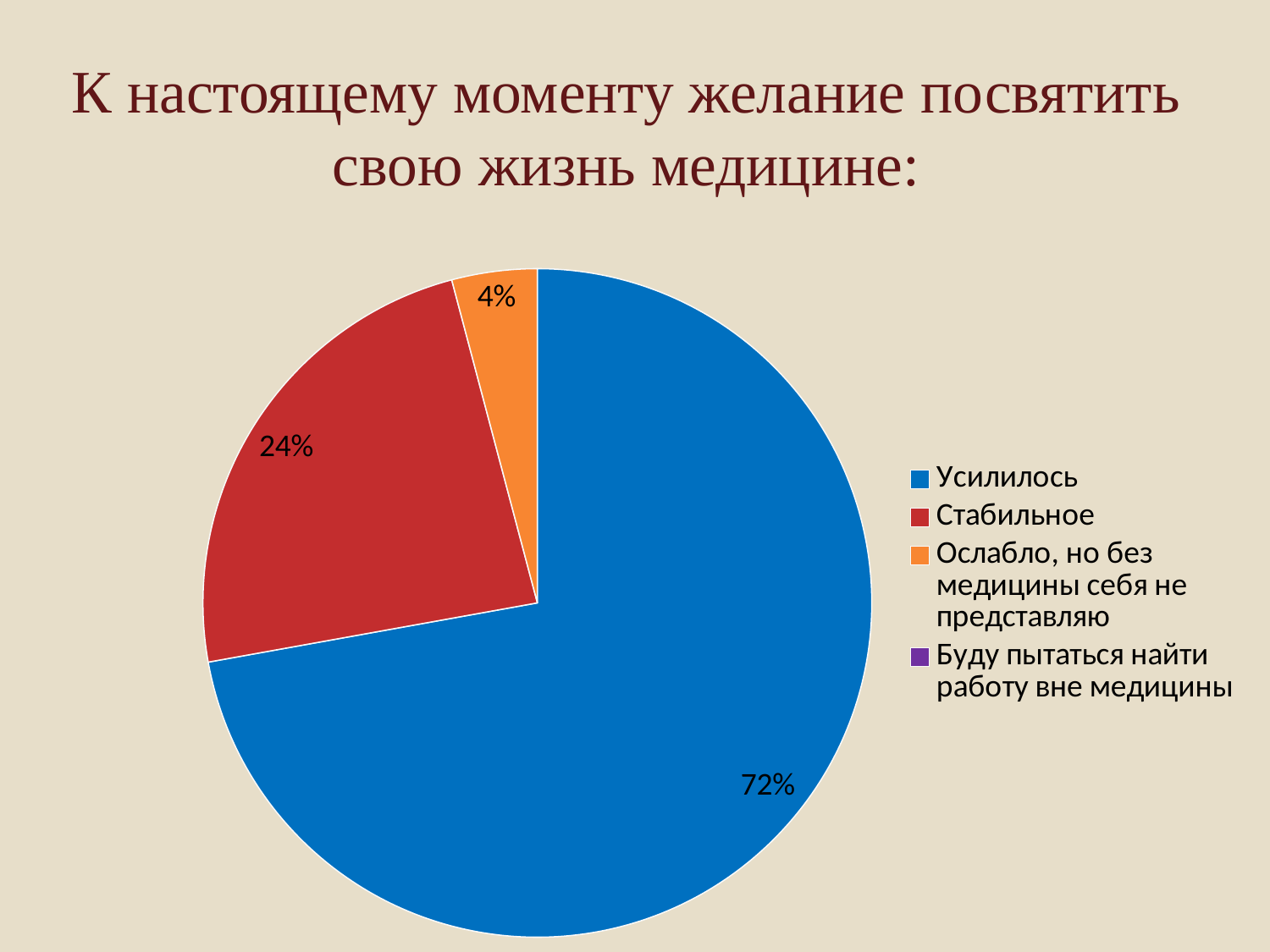
Which category has the largest slice of the pie? Усилилось What share of the pie is labelled for "Ослабло, но без медицины себя не представляю"? 4% How many slices of the pie have a percentage label? 3 Which slice is larger: "Стабильное" or "Ослабло, но без медицины себя не представляю"? Стабильное What kind of chart is shown on the slide? pie chart What colour is the slice for "Усилилось"? blue Which legend entry is shown in purple? Буду пытаться найти работу вне медицины What is the difference in percentage points between the "Усилилось" slice and the "Стабильное" slice? 48 Which of the labelled slices is the smallest? Ослабло, но без медицины себя не представляю What share of the pie is labelled for "Стабильное"? 24% How many entries does the legend list? 4 What share of the pie is labelled for "Усилилось"? 72%